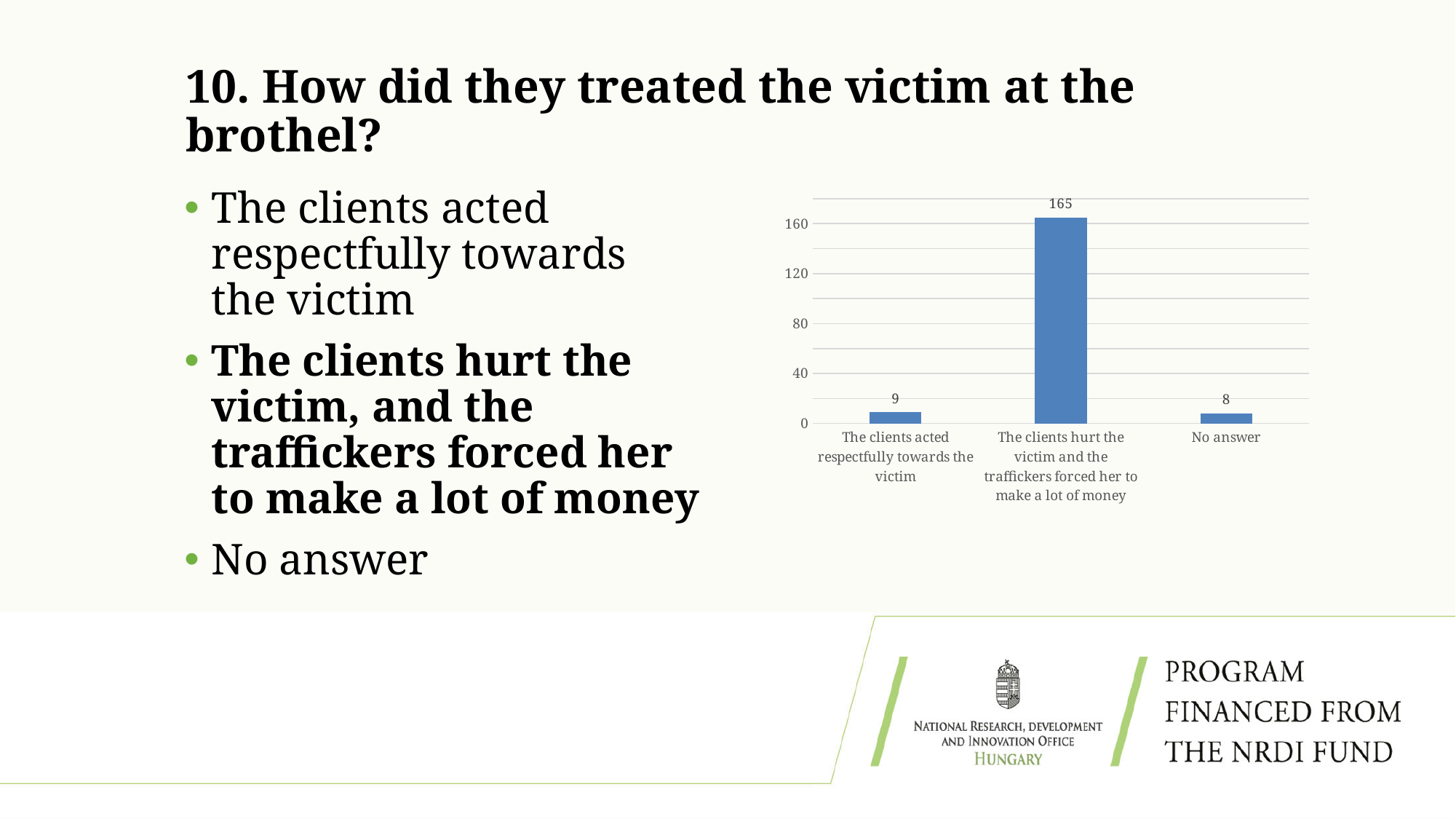
What is the difference between the value for "The clients acted respectfully towards the victim" and the value for "No answer"? 1 What is the value for "No answer"? 8 Is the value for "The clients hurt the victim and the traffickers forced her to make a lot of money" greater or less than 160? greater Which is larger: the value for "The clients acted respectfully towards the victim" or the value for "No answer"? The clients acted respectfully towards the victim What kind of chart is shown on the slide? Bar chart Which category has the highest value? The clients hurt the victim and the traffickers forced her to make a lot of money What is the value for "The clients acted respectfully towards the victim"? 9 Which category has the lowest value? No answer How many categories are shown on the chart? 3 What is the value for "The clients hurt the victim and the traffickers forced her to make a lot of money"? 165 What is the difference between the value for "The clients hurt the victim and the traffickers forced her to make a lot of money" and the value for "The clients acted respectfully towards the victim"? 156 What is the total of all three values shown on the chart? 182